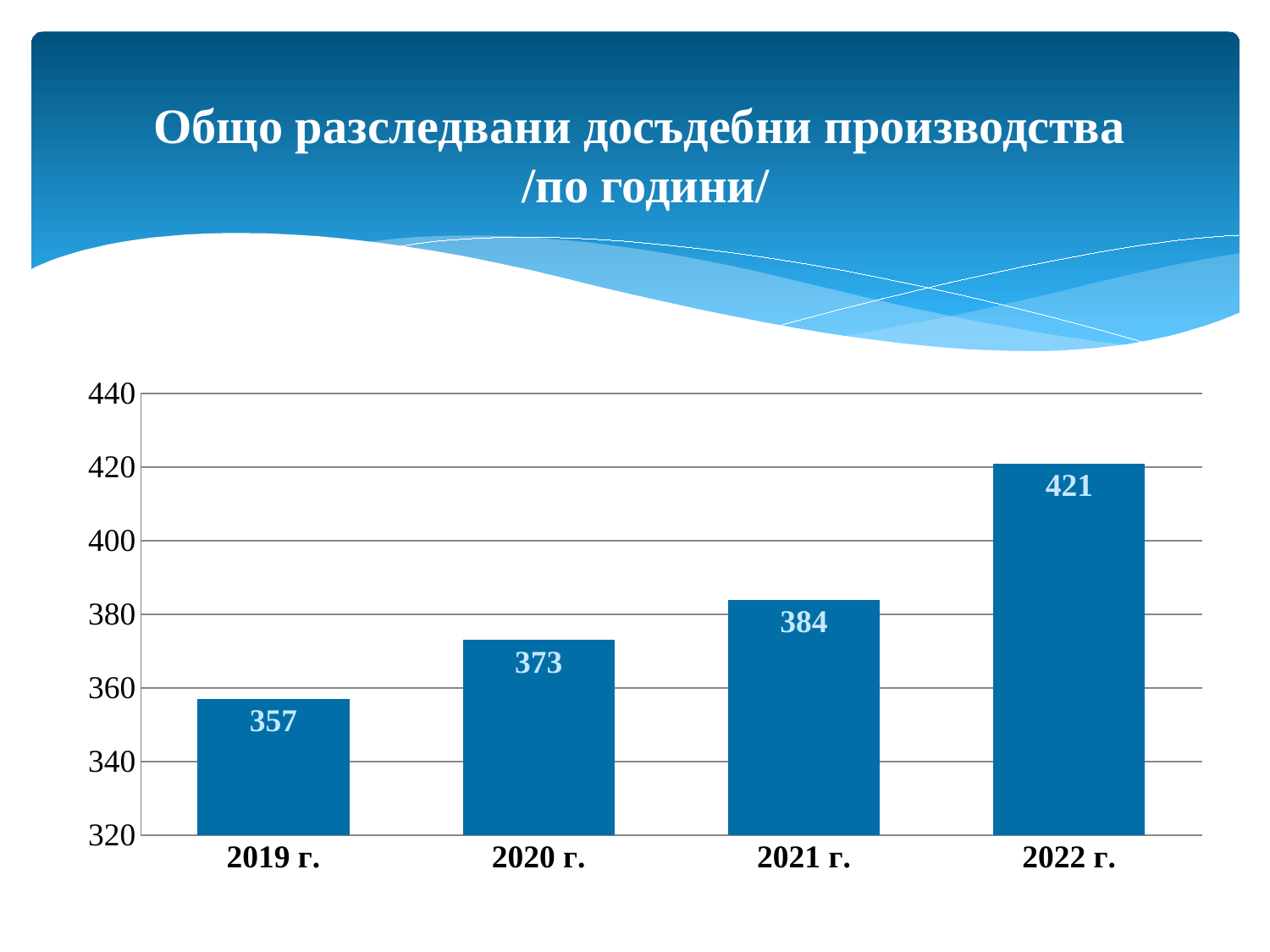
What is the value for 2021 г.? 384 What is the difference between the values for 2021 г. and 2020 г.? 11 What is the difference between the values for 2022 г. and 2019 г.? 64 How many years are shown on the chart? 4 Which year has the highest value? 2022 г. Is the value for 2022 г. greater or less than 400? greater What is the value for 2022 г.? 421 Which year has the lowest value? 2019 г. What kind of chart is shown on the slide? bar chart Do the values rise or fall from 2019 г. to 2022 г.? rise Which is larger, the value for 2020 г. or the value for 2021 г.? 2021 г. What is the value for 2019 г.? 357